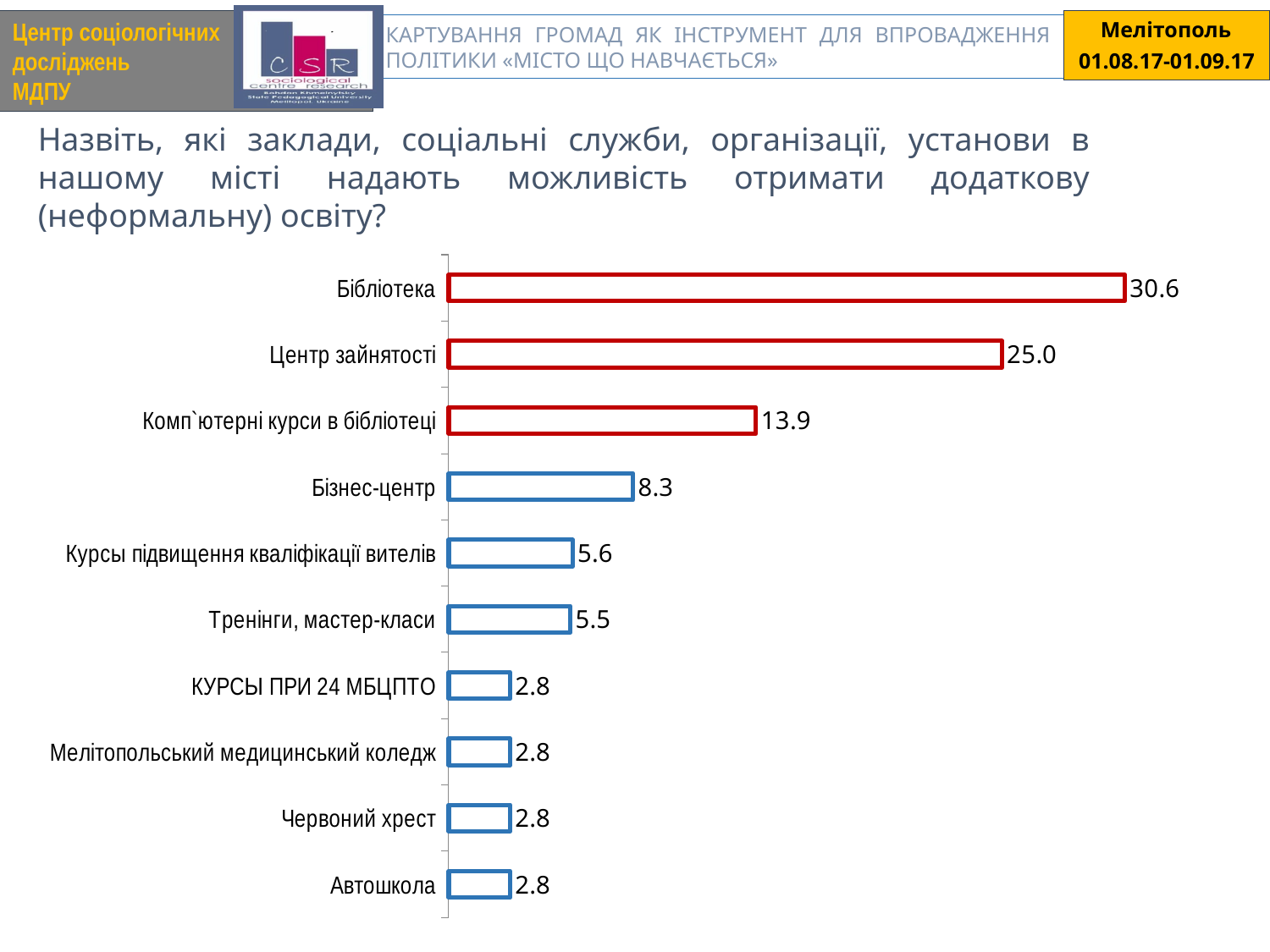
What value is shown for Автошкола? 2.8 What value is shown for Комп`ютерні курси в бібліотеці? 13.9 What value is shown for Тренінги, мастер-класи? 5.5 Which category has the highest value? Бібліотека Which is larger, the value for Центр зайнятості or the value for Комп`ютерні курси в бібліотеці? Центр зайнятості How many categories are shown in the chart? 10 What value is shown for Бізнес-центр? 8.3 What kind of chart is shown on the slide? bar chart What value is shown for Центр зайнятості? 25.0 What is the difference between the values for Бібліотека and Центр зайнятості? 5.6 What value is shown for Бібліотека? 30.6 What is the difference between the values for Комп`ютерні курси в бібліотеці and Бізнес-центр? 5.6